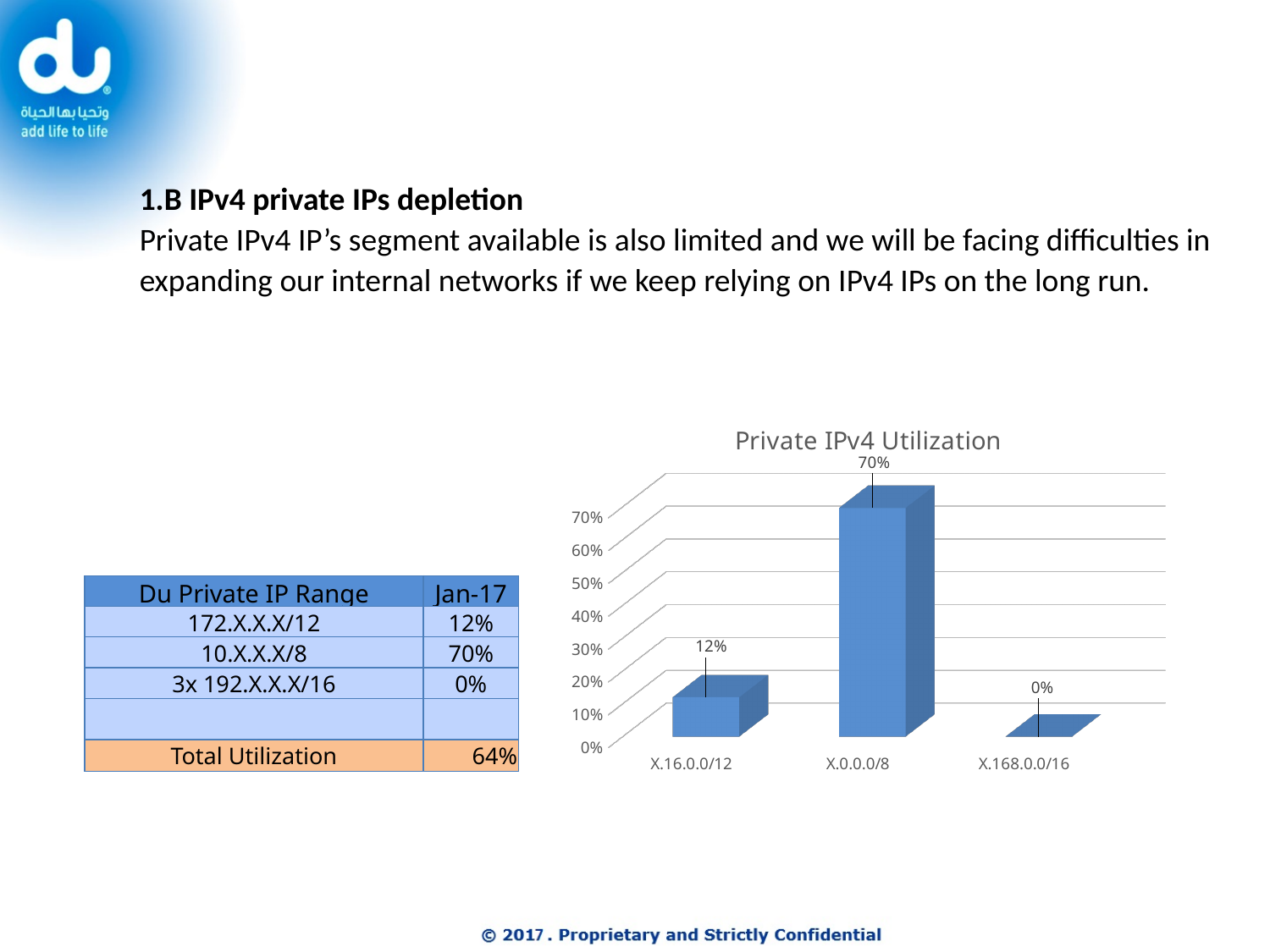
What is the value for X.168.0.0/16 in the chart? 0% How many categories are shown on the x axis of the chart? 3 What is the title of the chart? Private IPv4 Utilization Which is larger, the value for X.16.0.0/12 or the value for X.168.0.0/16? X.16.0.0/12 Is the value for X.0.0.0/8 greater or less than 50%? greater What kind of chart is shown on the slide? bar chart Which category has the lowest value in the chart? X.168.0.0/16 What is the value for X.16.0.0/12 in the chart? 12% What is the highest value shown on the chart's y axis? 70% What is the difference between the values for X.0.0.0/8 and X.16.0.0/12? 58% What is the value for X.0.0.0/8 in the chart? 70% Which category has the highest value in the chart? X.0.0.0/8